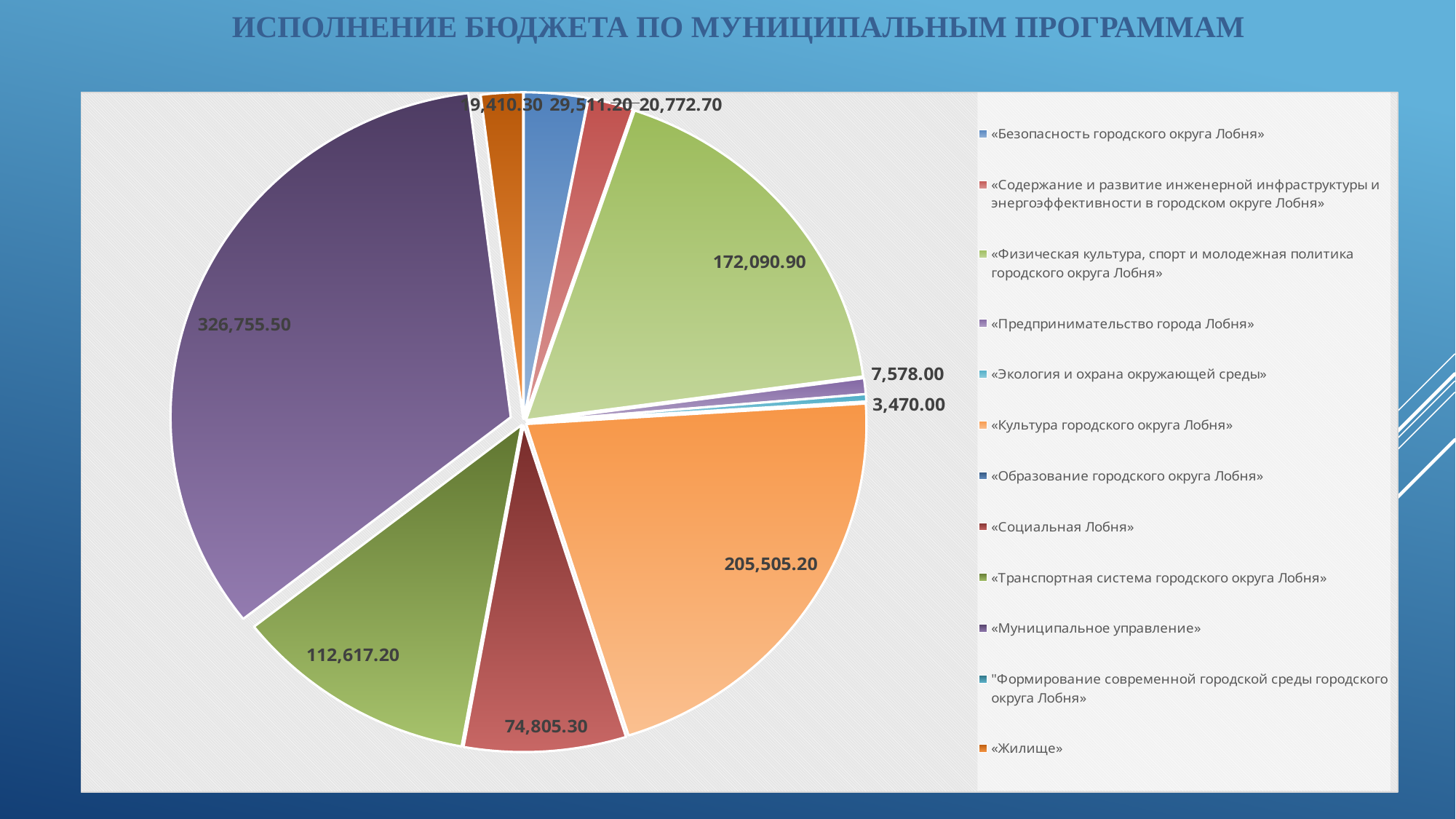
What is the value for «Транспортная система городского округа Лобня»? 112,617.20 What is the value for «Муниципальное управление»? 326,755.50 What is the value for «Культура городского округа Лобня»? 205,505.20 What is the value for «Экология и охрана окружающей среды»? 3,470.00 What is the difference between the values for «Муниципальное управление» and «Культура городского округа Лобня»? 121,250.30 What is the title of the chart? ИСПОЛНЕНИЕ БЮДЖЕТА ПО МУНИЦИПАЛЬНЫМ ПРОГРАММАМ What is the value for «Физическая культура, спорт и молодежная политика городского округа Лобня»? 172,090.90 What type of chart is shown on the slide? Pie chart Which program has the largest slice of the pie? «Муниципальное управление» Which is larger: the value for «Транспортная система городского округа Лобня» or for «Социальная Лобня»? «Транспортная система городского округа Лобня» What is the value for «Социальная Лобня»? 74,805.30 How many entries does the legend list? 12